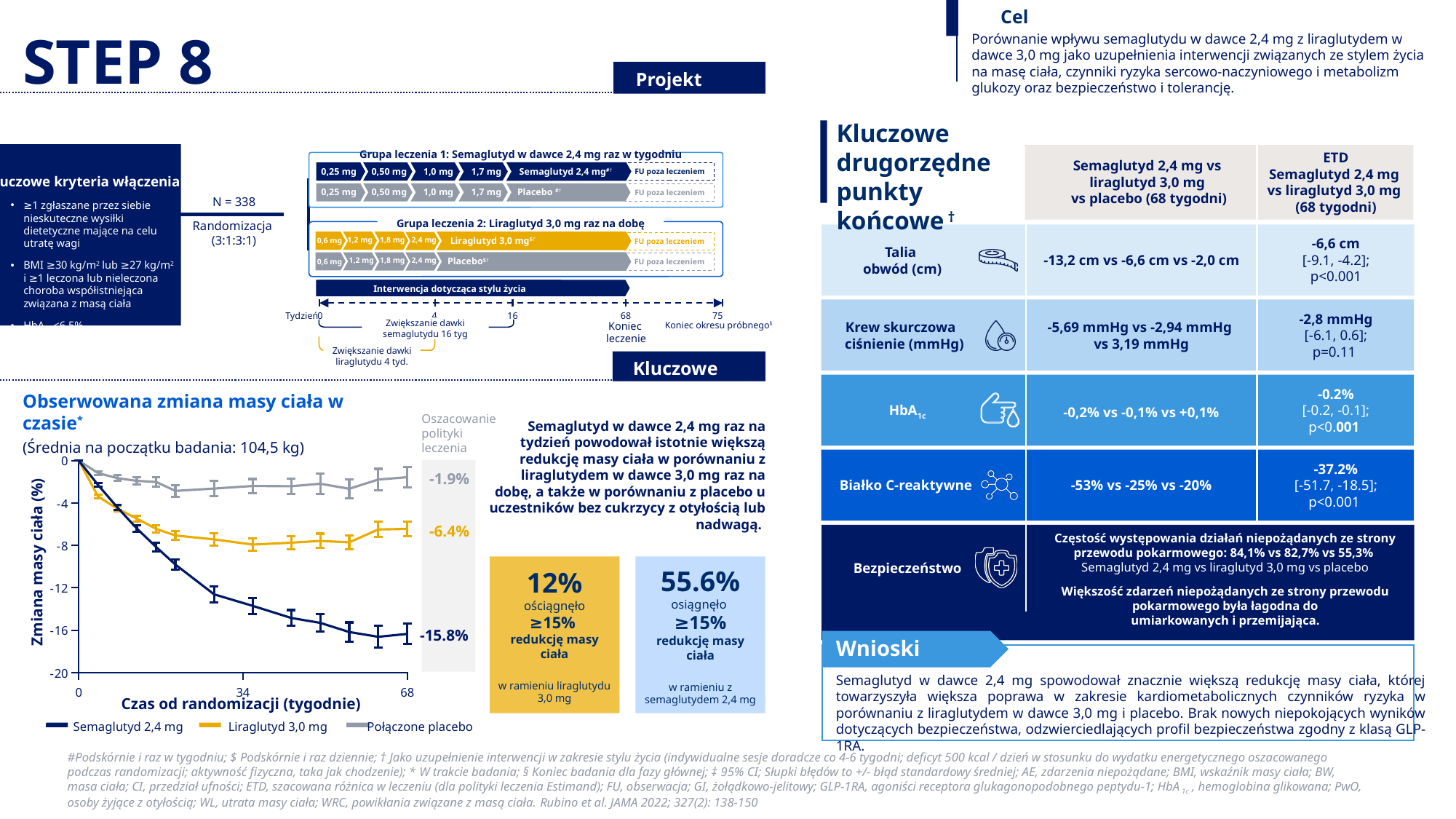
In the chart 'Obserwowana zmiana masy ciała w czasie', which series shows the smallest weight change at the end of the study? Połączone placebo In the chart 'Obserwowana zmiana masy ciała w czasie', which series shows the largest weight reduction at the end of the study? Semaglutyd 2,4 mg In the chart 'Obserwowana zmiana masy ciała w czasie', is the final value for Semaglutyd 2,4 mg greater or less than -12? less In the chart 'Obserwowana zmiana masy ciała w czasie', what is the final value shown for Semaglutyd 2,4 mg? -15.8% In the chart 'Obserwowana zmiana masy ciała w czasie', what is the difference between the final values for Semaglutyd 2,4 mg and Liraglutyd 3,0 mg? 9.4 percentage points What type of chart is 'Obserwowana zmiana masy ciała w czasie'? line chart In the chart 'Obserwowana zmiana masy ciała w czasie', what is the last tick value on the x axis? 68 In the chart 'Obserwowana zmiana masy ciała w czasie', what is the final value shown for Połączone placebo? -1.9% In the chart 'Obserwowana zmiana masy ciała w czasie', what is the label of the y axis? Zmiana masy ciała (%) In the chart 'Obserwowana zmiana masy ciała w czasie', does the Semaglutyd 2,4 mg line rise or fall over time? fall How many series does the legend of the chart 'Obserwowana zmiana masy ciała w czasie' list? 3 In the chart 'Obserwowana zmiana masy ciała w czasie', what is the final value shown for Liraglutyd 3,0 mg? -6.4%